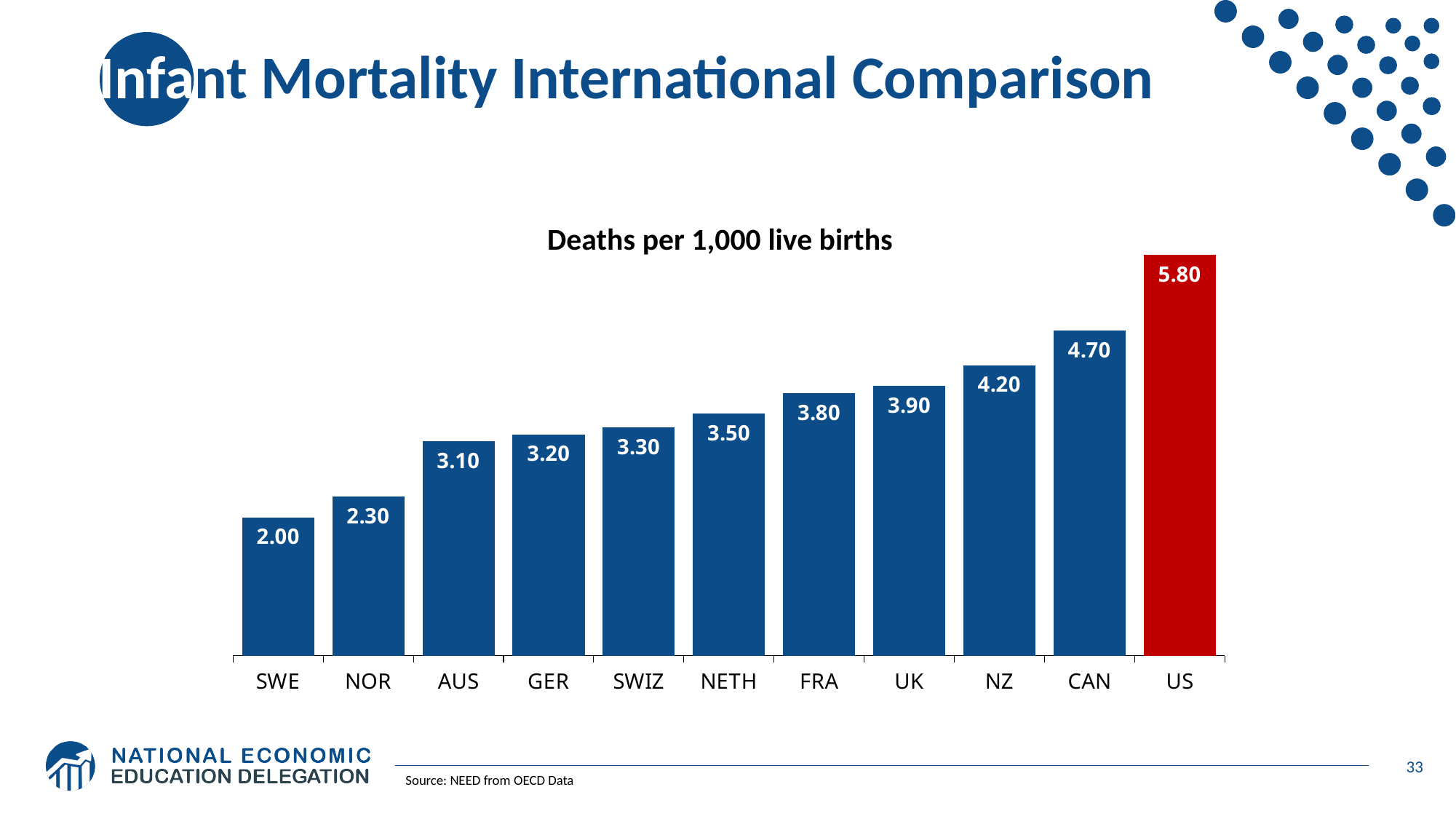
What is the value for SWE? 2.00 What is the title of the chart? Deaths per 1,000 live births Which is larger, the value for NZ or the value for GER? NZ Which country has the lowest value? SWE Do the values rise or fall from left to right along the x axis? rise What is the difference between the values for UK and SWE? 1.90 How many countries are shown in the chart? 11 What is the value for NETH? 3.50 What is the difference between the values for the US and CAN? 1.10 What is the value for the US? 5.80 What kind of chart is shown on the slide? bar chart Which country has the highest value? US